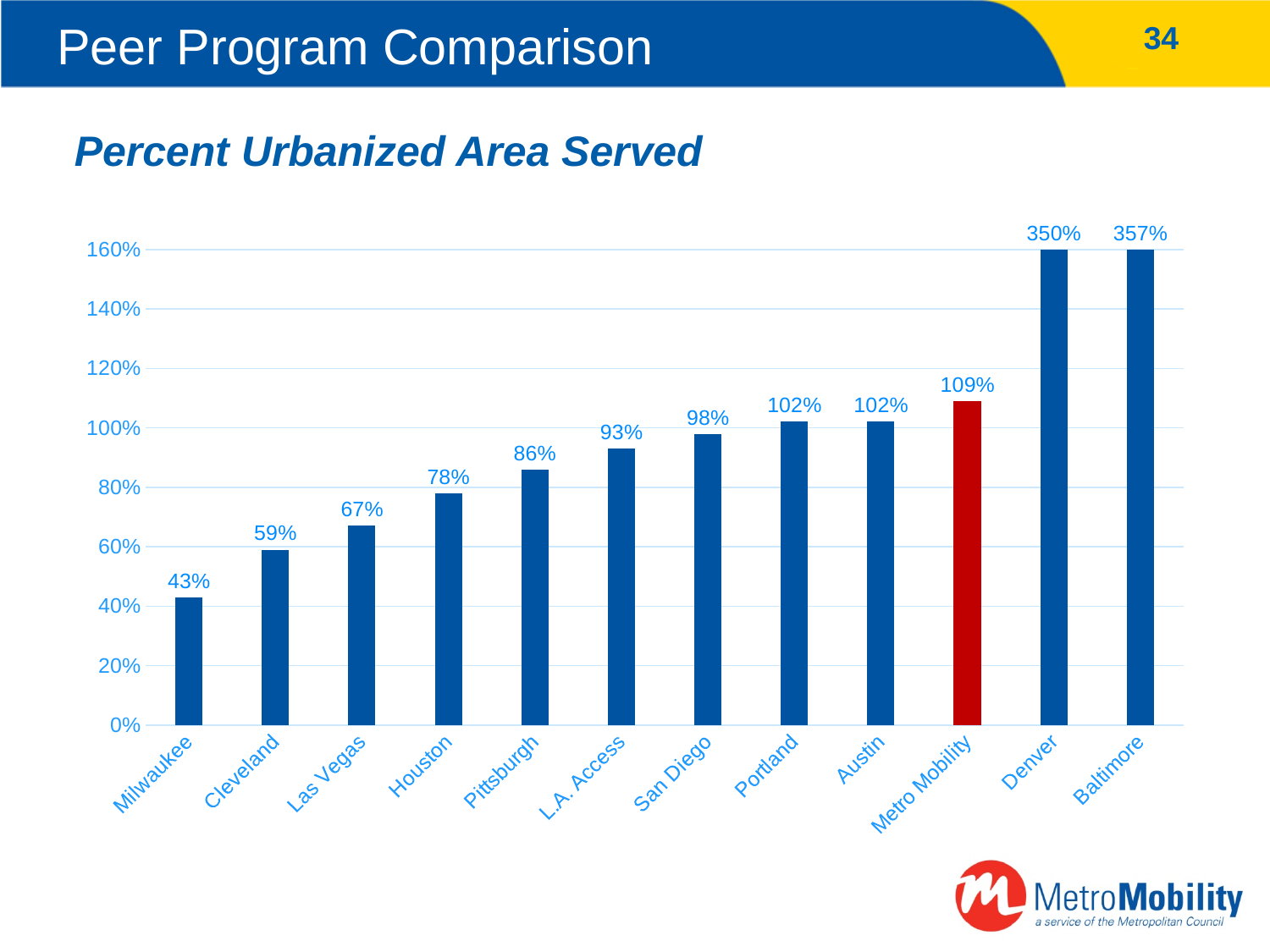
What is the difference between the values for Baltimore and Denver? 7% What kind of chart is shown on the slide? Bar chart What is the value shown for Milwaukee? 43% Which bar is coloured red instead of blue? Metro Mobility Which program has the lowest percent urbanized area served? Milwaukee Which program has the highest percent urbanized area served? Baltimore What is the percent urbanized area served for Metro Mobility? 109% What is the difference between the values for Metro Mobility and Houston? 31% How many programs are shown on the x axis? 12 Which has a larger value, Las Vegas or L.A. Access? L.A. Access What is the value shown for Pittsburgh? 86% Do the values generally rise or fall from left to right along the x axis? Rise